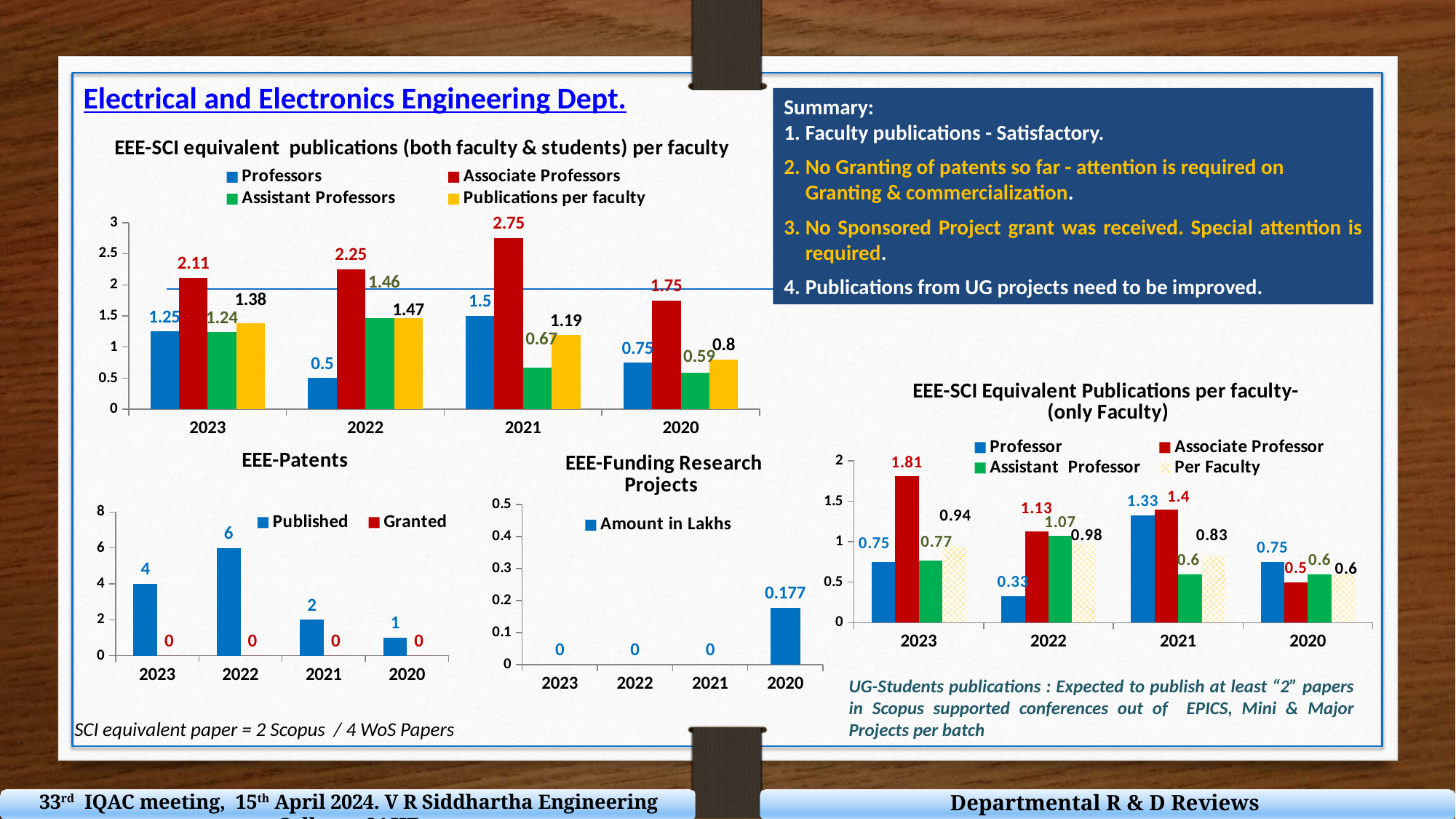
In the 'EEE-SCI Equivalent Publications per faculty- (only Faculty)' chart, which is larger in 2021: Professor or Assistant Professor? Professor In the 'EEE-Patents' chart, which year has the lowest Published value? 2020 In the 'EEE-SCI equivalent publications (both faculty & students) per faculty' chart, which year has the highest value for Professors? 2021 In the 'EEE-SCI equivalent publications (both faculty & students) per faculty' chart, what is the value for Associate Professors in 2021? 2.75 In the 'EEE-SCI equivalent publications (both faculty & students) per faculty' chart, what is the difference between the Associate Professors value and the Professors value in 2022? 1.75 In the 'EEE-Patents' chart, what is the Published value for 2022? 6 How many years are shown on the x axis of the 'EEE-SCI Equivalent Publications per faculty- (only Faculty)' chart? 4 How many series does the legend of the 'EEE-SCI equivalent publications (both faculty & students) per faculty' chart list? 4 In the 'EEE-Patents' chart, what is the Granted value for 2023? 0 In the 'EEE-Funding Research Projects' chart, what is the Amount in Lakhs for 2020? 0.177 What kind of chart is 'EEE-Funding Research Projects'? Bar chart In the 'EEE-SCI Equivalent Publications per faculty- (only Faculty)' chart, what is the Associate Professor value for 2023? 1.81